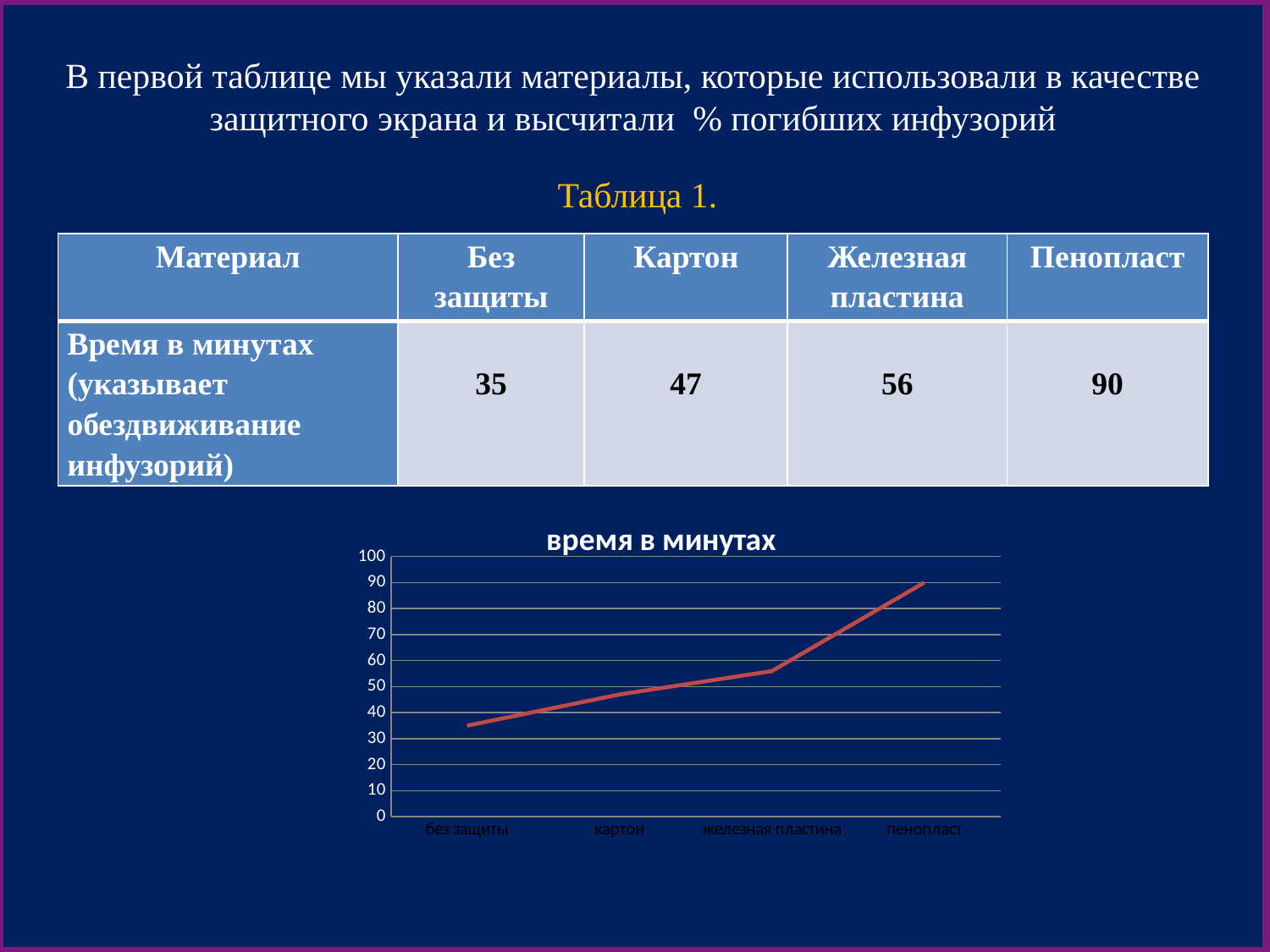
What is the difference between the time for пенопласт and the time for без защиты, using the values in the table? 55 What kind of chart is shown on the slide? line chart What is the time in minutes for картон, as given in the table? 47 Is the value for без защиты greater or less than 40? less Which is larger, the value for картон or the value for железная пластина? железная пластина Which category has the highest value in the chart? пенопласт Is the value for пенопласт greater or less than 80? greater How many categories are plotted along the x axis of the chart? 4 Do the values rise or fall along the x axis from без защиты to пенопласт? rise Is the value for железная пластина greater or less than 50? greater What is the title of the chart? время в минутах Which category has the lowest value in the chart? без защиты